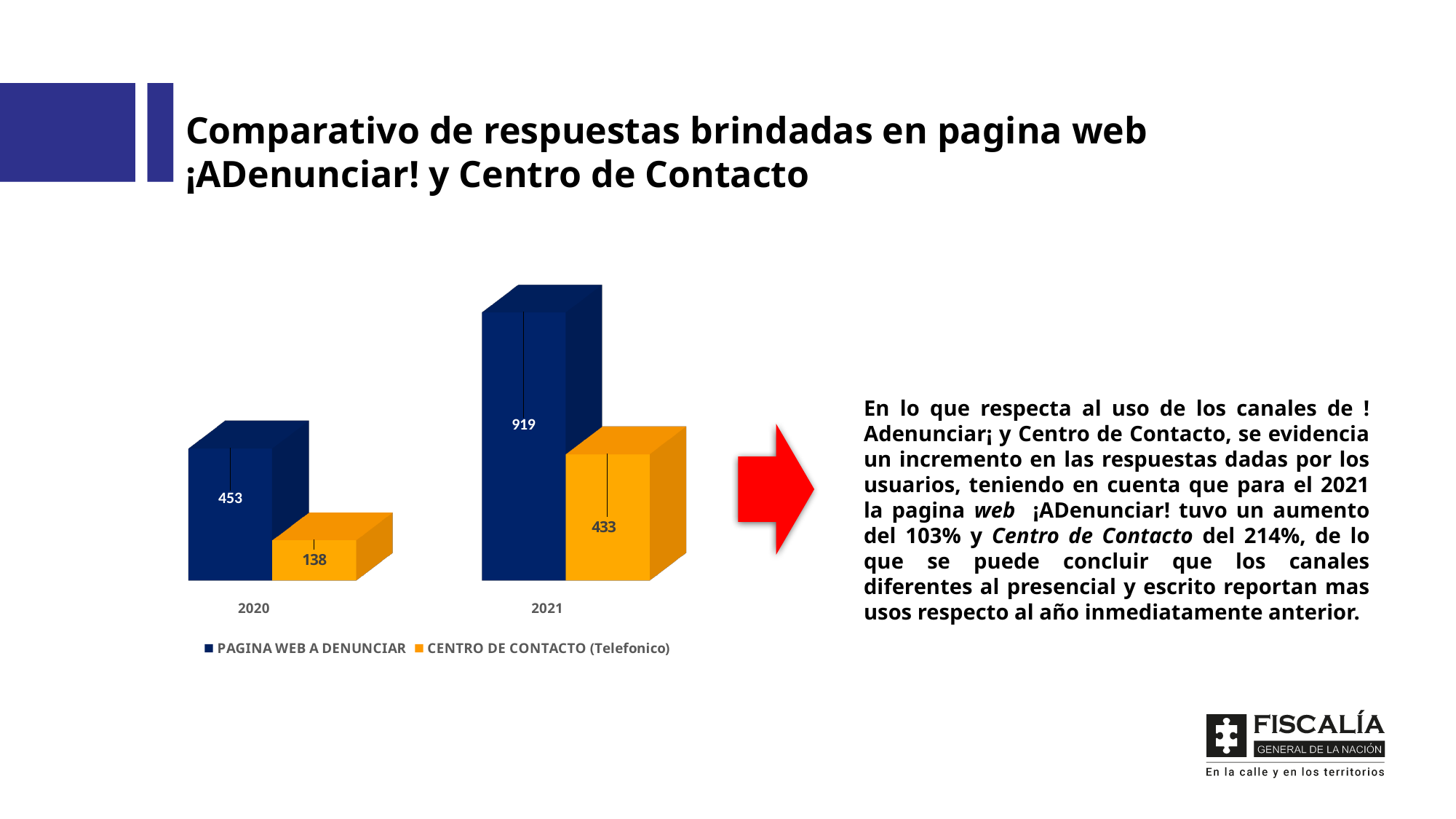
What is the value for PAGINA WEB A DENUNCIAR in 2021? 919 Does the value for CENTRO DE CONTACTO (Telefonico) rise or fall from 2020 to 2021? Rise What is the value for PAGINA WEB A DENUNCIAR in 2020? 453 What is the difference between the CENTRO DE CONTACTO (Telefonico) values for 2021 and 2020? 295 What is the value for CENTRO DE CONTACTO (Telefonico) in 2020? 138 What is the value for CENTRO DE CONTACTO (Telefonico) in 2021? 433 Which year has the lowest value for CENTRO DE CONTACTO (Telefonico)? 2020 How many series does the legend list? 2 In 2021, which series has the larger value: PAGINA WEB A DENUNCIAR or CENTRO DE CONTACTO (Telefonico)? PAGINA WEB A DENUNCIAR Which year has the highest value for PAGINA WEB A DENUNCIAR? 2021 What kind of chart is shown on the slide? Bar chart What is the difference between the PAGINA WEB A DENUNCIAR values for 2021 and 2020? 466